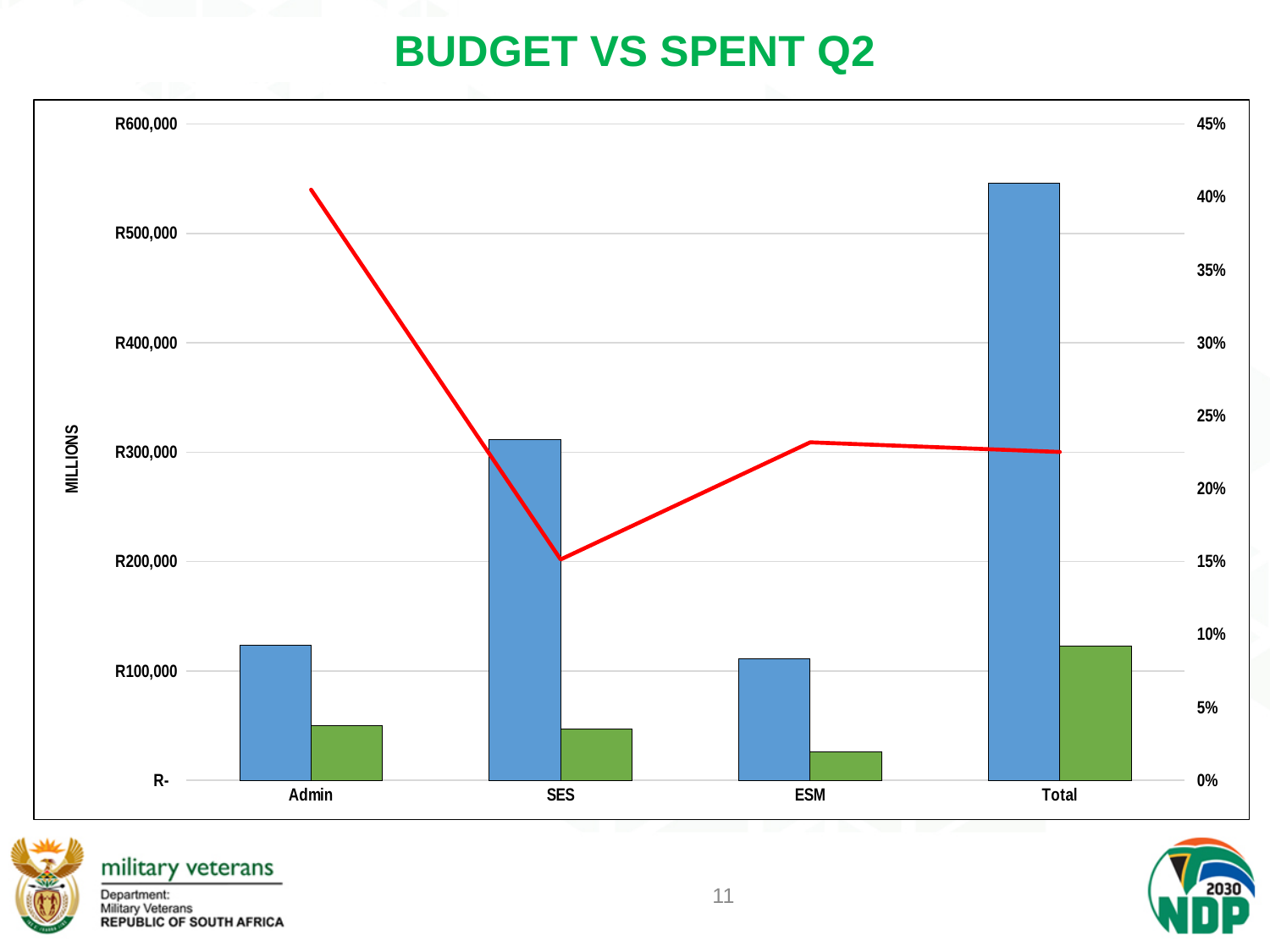
How many categories are shown on the x axis? 4 What kind of chart is shown on the slide? A bar chart combined with a line Which has the larger blue bar, SES or Admin? SES Which category has the shortest blue bar? ESM What is the label on the left vertical axis? MILLIONS Which category has the tallest blue bar? Total What is the title of the chart? BUDGET VS SPENT Q2 Is the red line value for Admin greater or less than 35%? greater Does the red line rise or fall from Admin to SES? fall Is the blue bar for Total greater or less than R500,000? greater Which category has the shortest green bar? ESM Is the blue bar for SES greater or less than R400,000? less